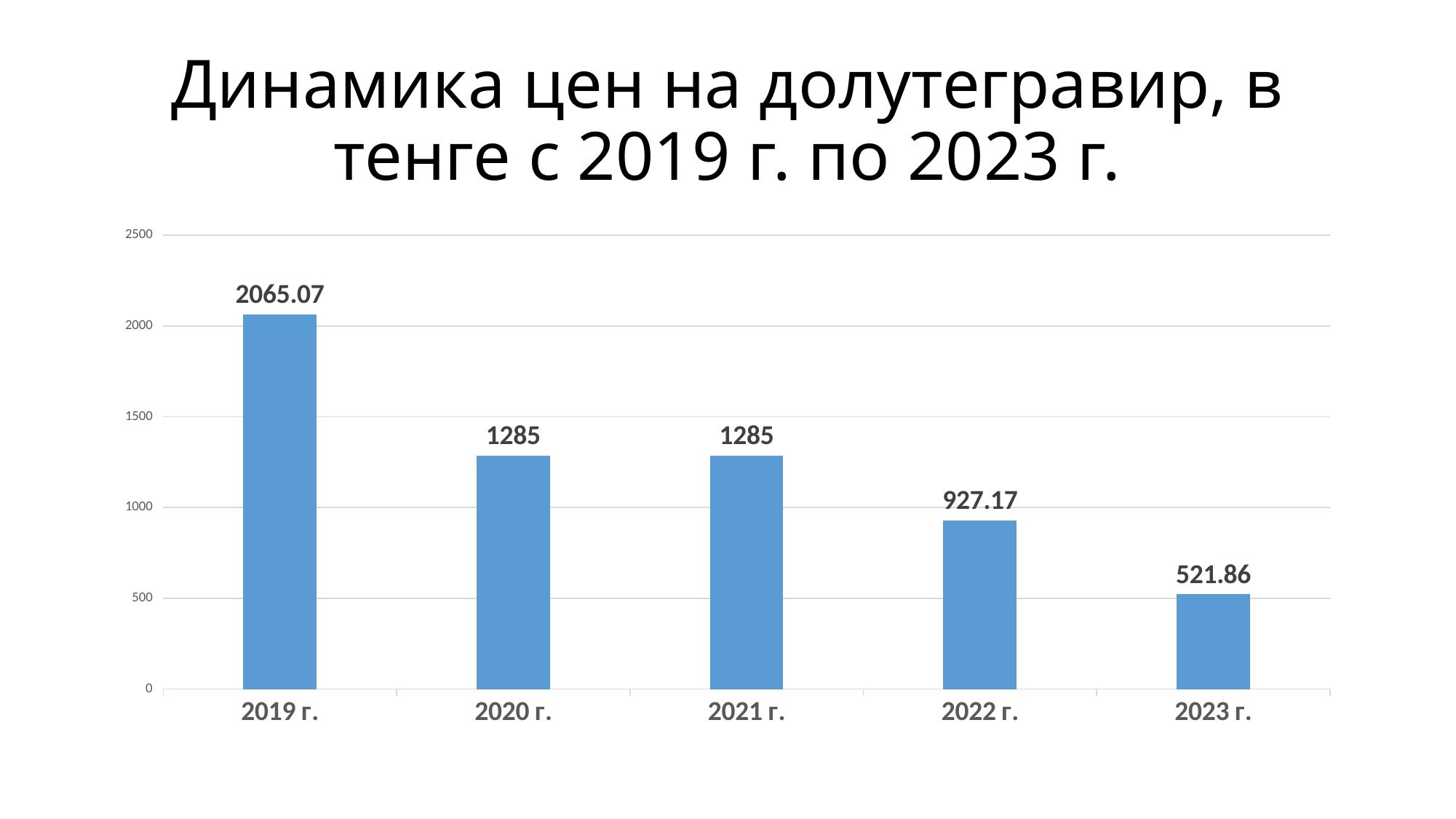
What is the difference between the values for 2022 г. and 2023 г.? 405.31 What kind of chart is shown on the slide? bar chart How many years are shown on the x axis? 5 Do the values rise or fall from 2019 г. to 2023 г.? fall Which year has the lowest value? 2023 г. What is the value shown for 2023 г.? 521.86 Which year has the highest value? 2019 г. What is the price of dolutegravir in 2019 г.? 2065.07 What is the difference between the values for 2019 г. and 2020 г.? 780.07 What is the value shown for 2022 г.? 927.17 Is the value for 2020 г. greater or less than 1500? less Which is larger, the value for 2021 г. or the value for 2022 г.? 2021 г.